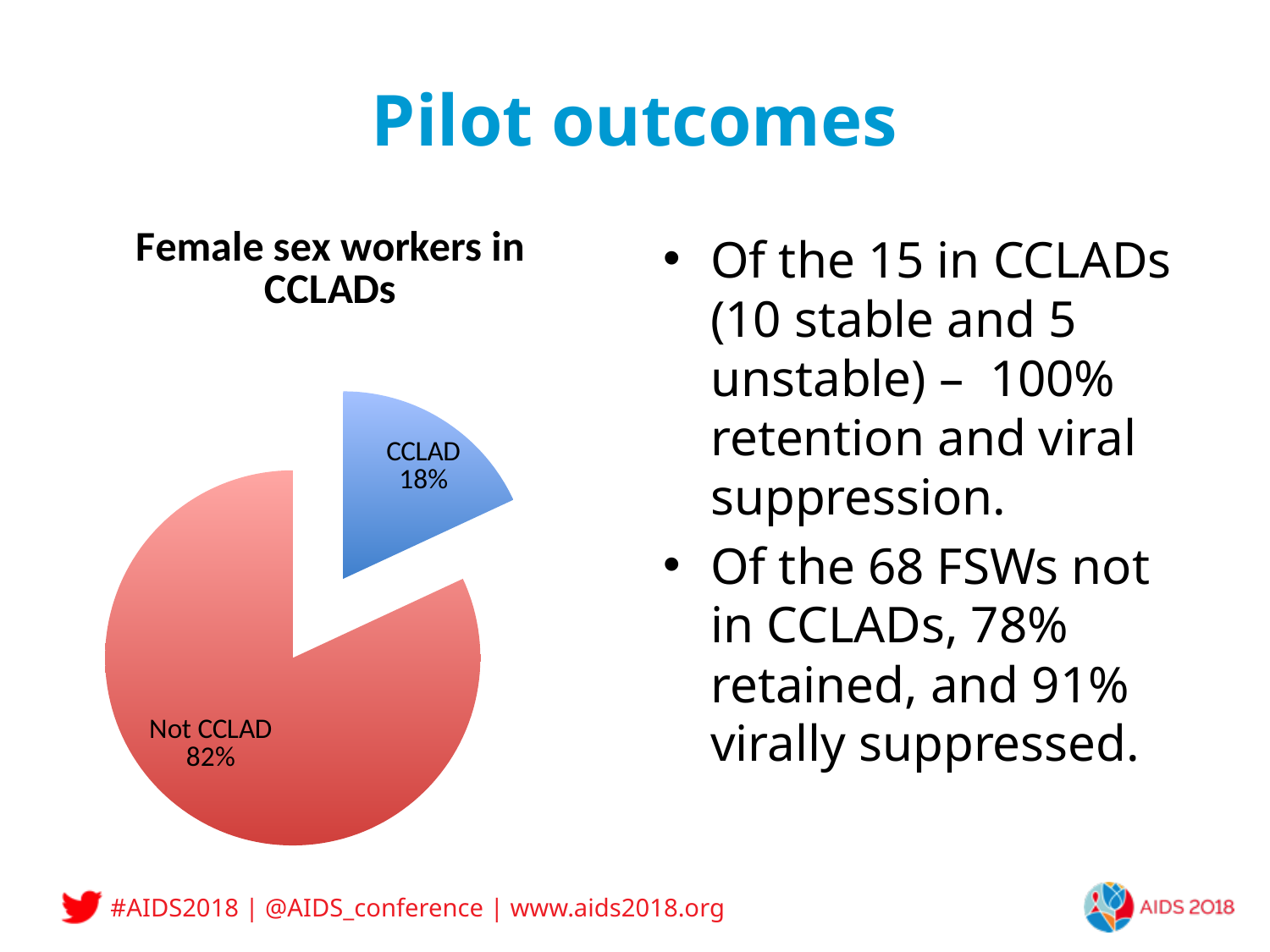
What colour is the CCLAD slice? blue What share of the pie does the Not CCLAD slice represent? 82% What kind of chart is shown on the slide? pie chart Which is larger, the CCLAD slice or the Not CCLAD slice? Not CCLAD How many slices does the pie chart have? 2 Which slice of the pie is the smallest? CCLAD What is the title of the chart? Female sex workers in CCLADs What is the difference in percentage points between the Not CCLAD and CCLAD slices? 64 What share of the pie does the CCLAD slice represent? 18% Which slice of the pie is the largest? Not CCLAD